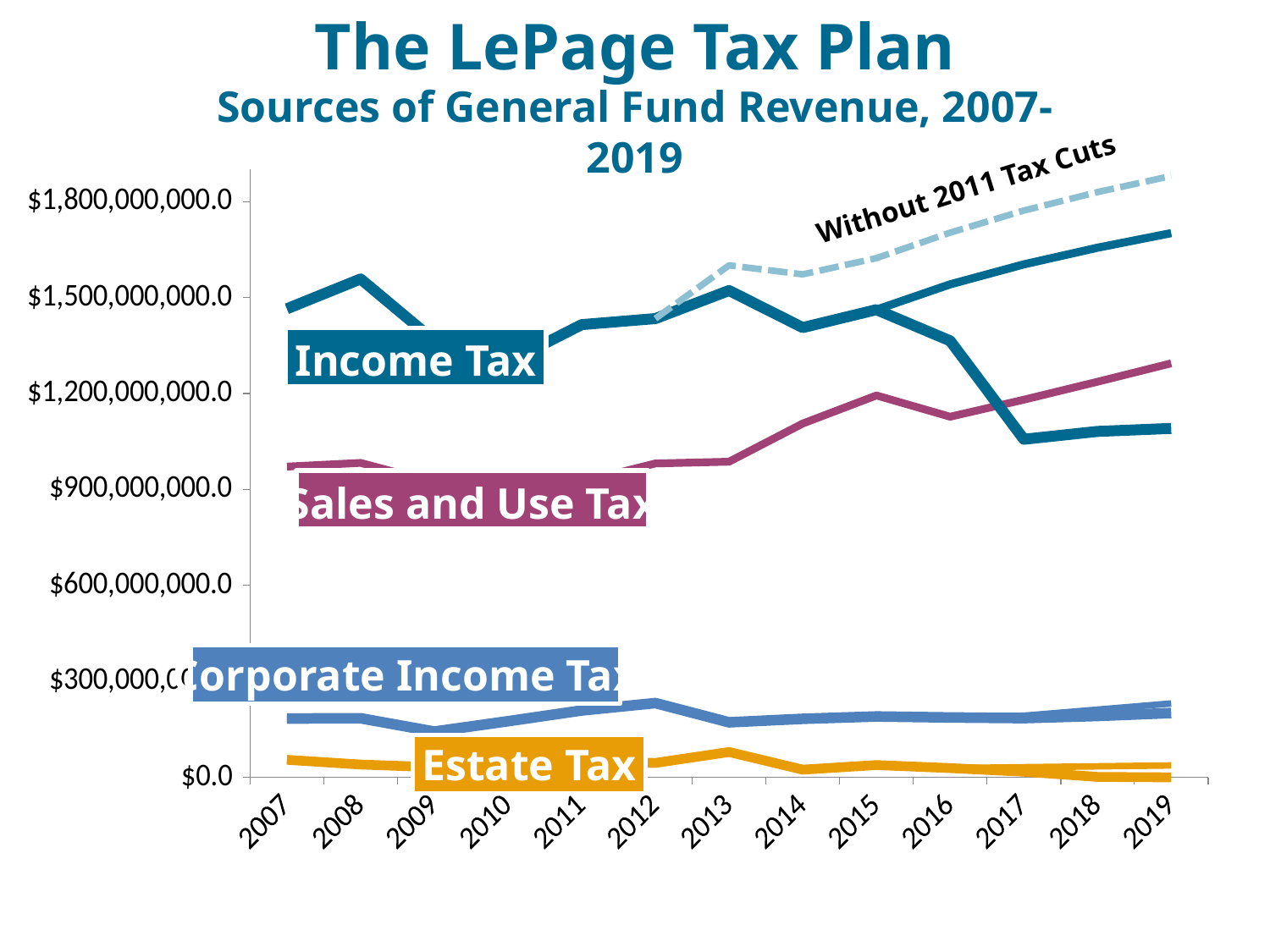
How many years are shown along the x axis? 13 In 2007, which is larger: Income Tax or Sales and Use Tax? Income Tax Is the value for Income Tax in 2008 greater or less than $1,500,000,000.0? greater Is the value for Sales and Use Tax in 2007 greater or less than $900,000,000.0? greater What kind of chart is shown on the slide? line chart What does the dashed line on the chart represent? Without 2011 Tax Cuts Is the value for Corporate Income Tax in 2012 greater or less than $300,000,000.0? less Which tax source has the lowest value in 2019? Estate Tax In 2013, which is larger: Corporate Income Tax or Estate Tax? Corporate Income Tax